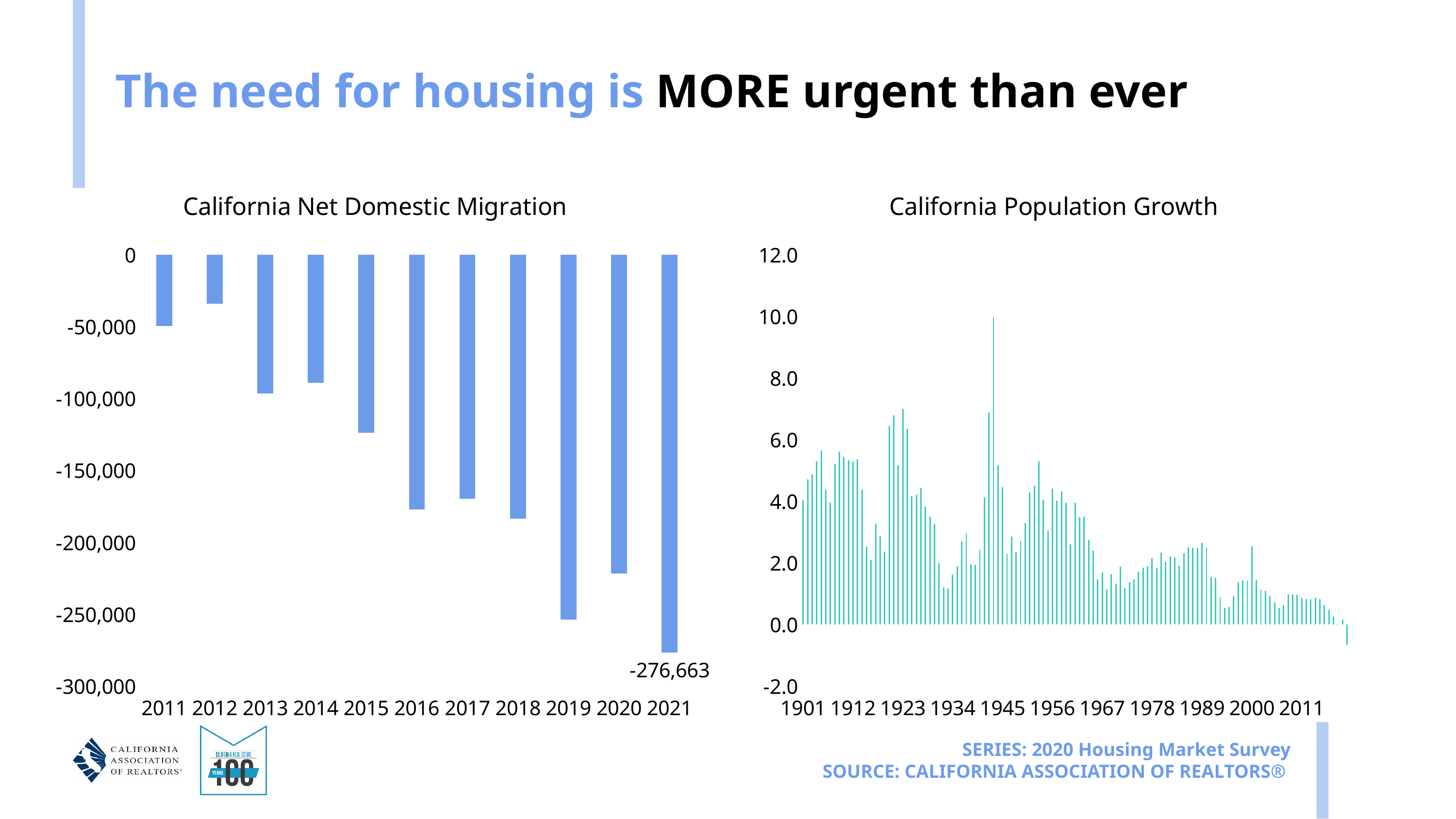
In the California Net Domestic Migration chart, is the value for 2015 greater or less than -100,000? less In the California Population Growth chart, what is the first year label on the x axis? 1901 In the California Net Domestic Migration chart, which year has the lowest (most negative) value? 2021 In the California Population Growth chart, is the tallest bar's value greater or less than 8.0? greater In the California Net Domestic Migration chart, which year has the larger net outflow, 2019 or 2020? 2019 In the California Net Domestic Migration chart, is the value for 2012 greater or less than -50,000? greater What kind of chart is the California Population Growth chart? bar chart In the California Net Domestic Migration chart, do the values generally rise or fall from 2011 to 2021? fall How many years are shown in the California Net Domestic Migration chart? 11 In the California Net Domestic Migration chart, which year has the highest (least negative) value? 2012 What kind of chart is the California Net Domestic Migration chart? bar chart In the California Net Domestic Migration chart, what is the value for 2021? -276,663